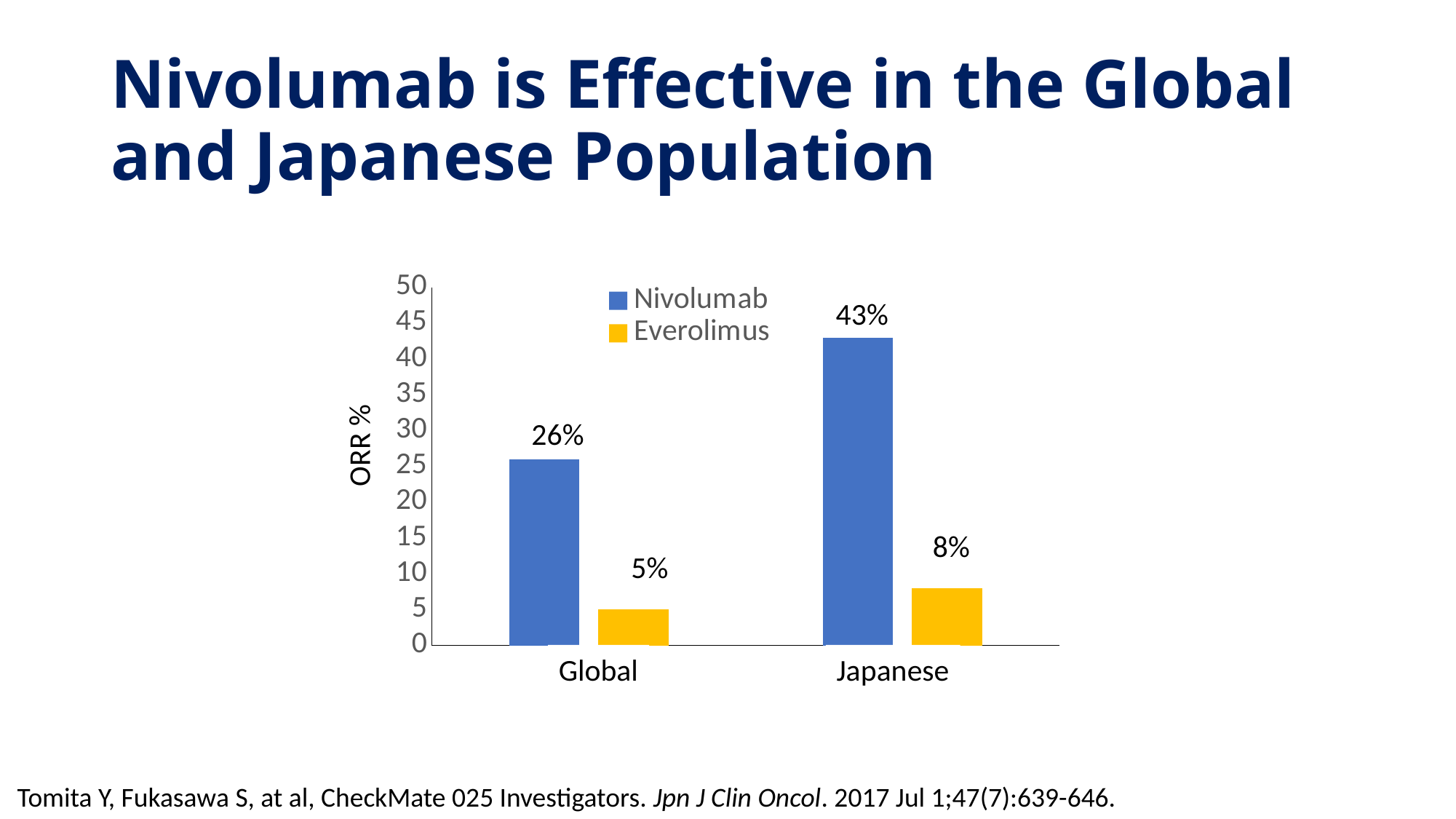
What is the ORR for Everolimus in the Global population? 5% How many population categories are shown on the x axis? 2 Which is larger: the Everolimus ORR in the Global population or in the Japanese population? Japanese What is the difference between the Nivolumab and Everolimus ORR in the Japanese population? 35% Which population has the highest ORR for Nivolumab? Japanese What is the difference between the Nivolumab ORR in the Japanese population and the Global population? 17% What is the ORR for Nivolumab in the Global population? 26% How many series does the legend list? 2 Is the Nivolumab ORR in the Japanese population greater or less than 40? greater What type of chart is shown on the slide? Bar chart Which bar shows the lowest ORR on the chart? Everolimus, Global What is the ORR for Everolimus in the Japanese population? 8%